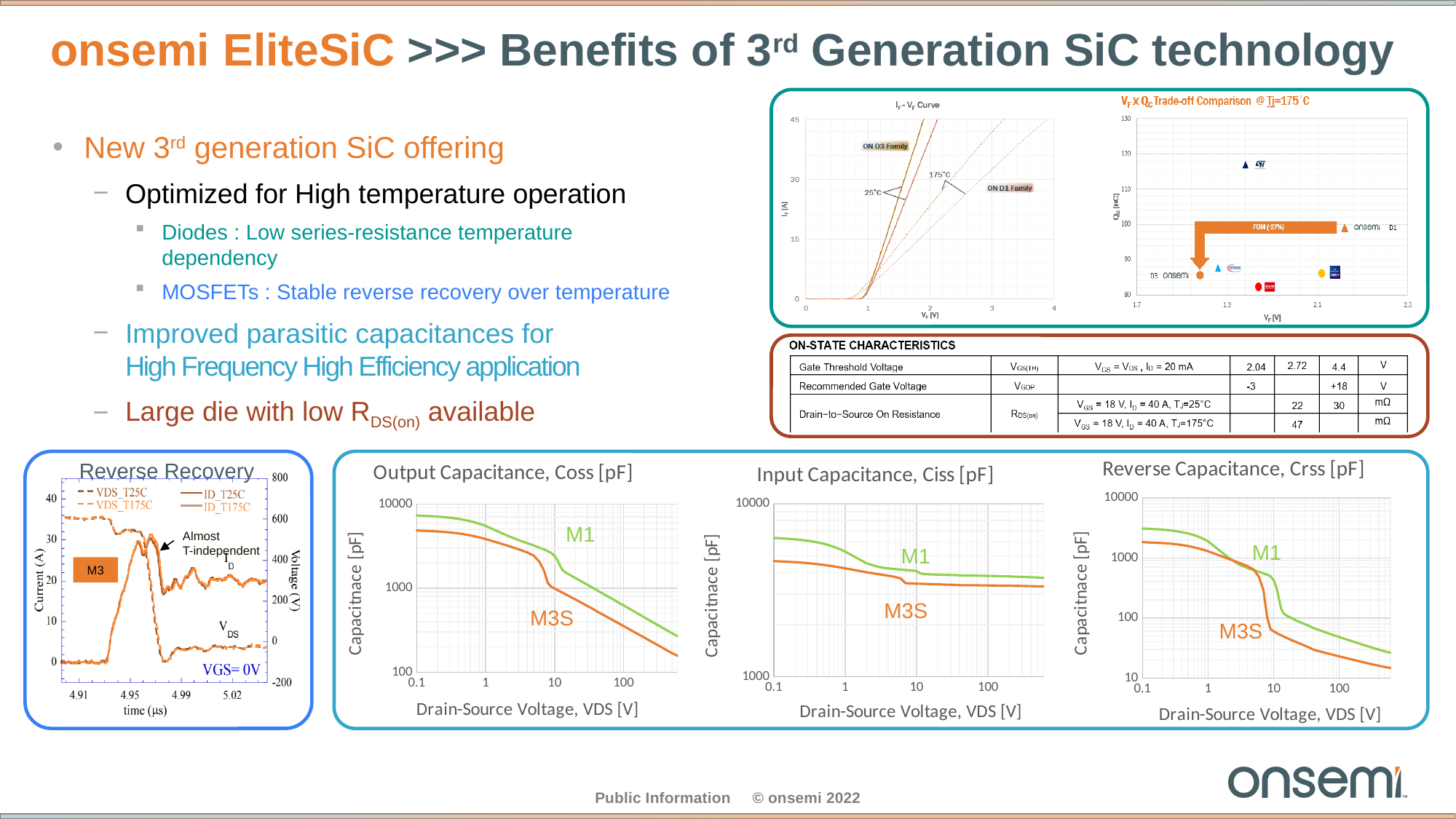
In the Reverse Capacitance, Crss [pF] chart, which series has the higher capacitance at 100 V, M1 or M3S? M1 How many series does the legend of the Reverse Recovery chart list? 4 In the IF - VF Curve chart, what is the highest value shown on the IF [A] axis? 45 What kind of chart is the Output Capacitance, Coss [pF] chart? line chart In the Output Capacitance, Coss [pF] chart, does the capacitance rise or fall as drain-source voltage increases? fall In the Reverse Capacitance, Crss [pF] chart, is the M3S capacitance at 100 V greater or less than 100 pF? less What is the x-axis label of the Input Capacitance, Ciss [pF] chart? Drain-Source Voltage, VDS [V] In the Input Capacitance, Ciss [pF] chart, is the M1 capacitance at 0.1 V greater or less than 1000 pF? greater In the Reverse Recovery chart, what is the label of the left y-axis? Current (A) In the Output Capacitance, Coss [pF] chart, which series has the higher capacitance at 0.1 V drain-source voltage, M1 or M3S? M1 In the Output Capacitance, Coss [pF] chart, how many series are plotted? 2 In the Output Capacitance, Coss [pF] chart, is the M3S capacitance at 100 V greater or less than 1000 pF? less